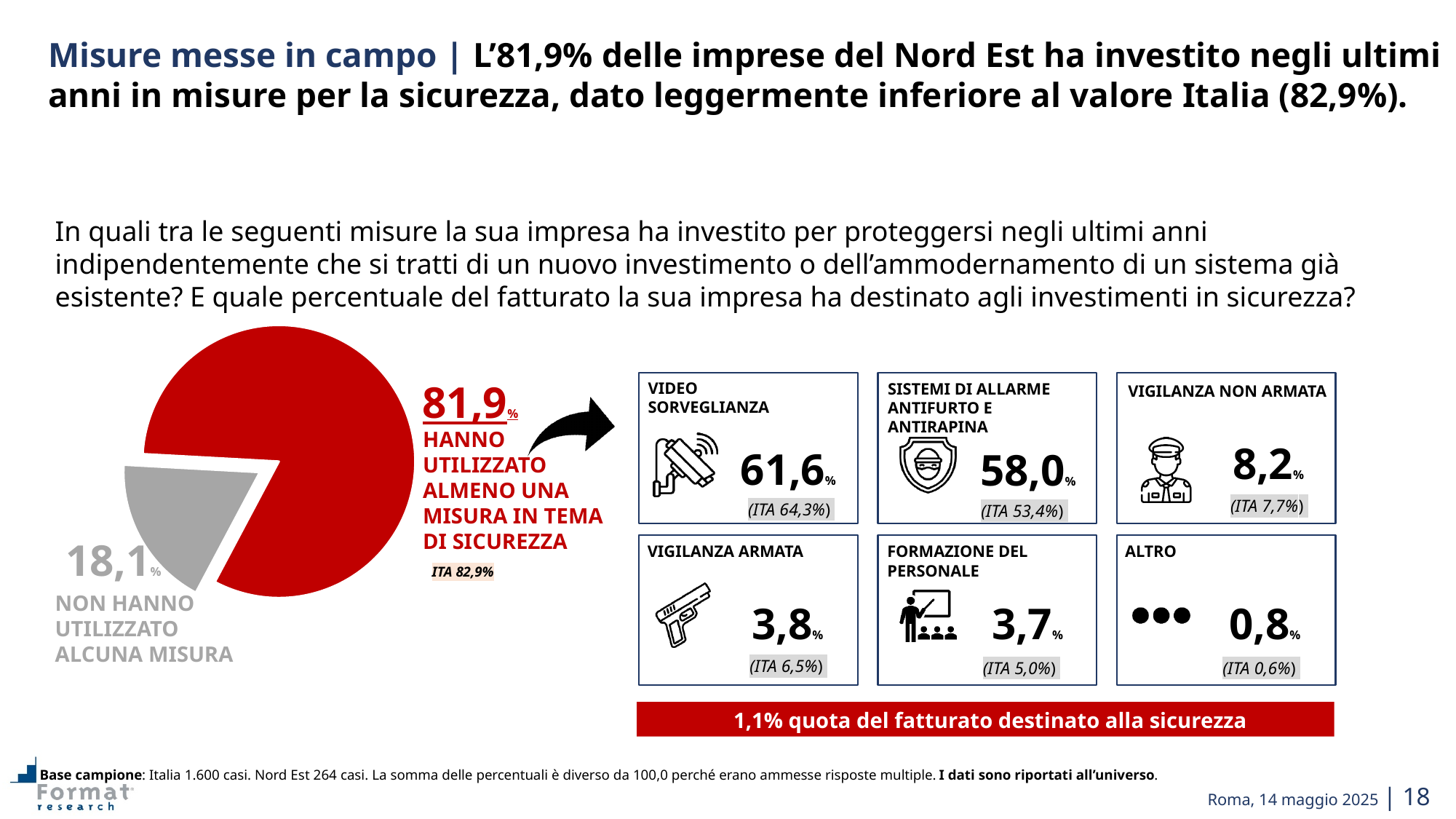
In the pie chart, what share of Nord Est firms have used at least one security measure (hanno utilizzato almeno una misura)? 81,9% Among the six measure boxes to the right of the pie chart, which measure has the highest Nord Est value? Video sorveglianza What is the difference in percentage points between the two slices of the pie chart (81,9% and 18,1%)? 63,8 How many slices does the pie chart have? 2 In the boxes to the right of the pie chart, what is the Italy (ITA) value for 'Sistemi di allarme antifurto e antirapina'? 53,4% What is the Italy (ITA) value shown next to the 81,9% slice? 82,9% In the boxes to the right of the pie chart, what is the Nord Est value for 'Video sorveglianza'? 61,6% Among the six measure boxes to the right of the pie chart, which measure has the lowest Nord Est value? Altro What kind of chart is shown on the left of the slide? pie chart Which slice of the pie chart is larger: 'hanno utilizzato almeno una misura' or 'non hanno utilizzato alcuna misura'? hanno utilizzato almeno una misura What colour is the slice representing firms that used at least one security measure? red In the pie chart, what share of firms have not used any measure (non hanno utilizzato alcuna misura)? 18,1%